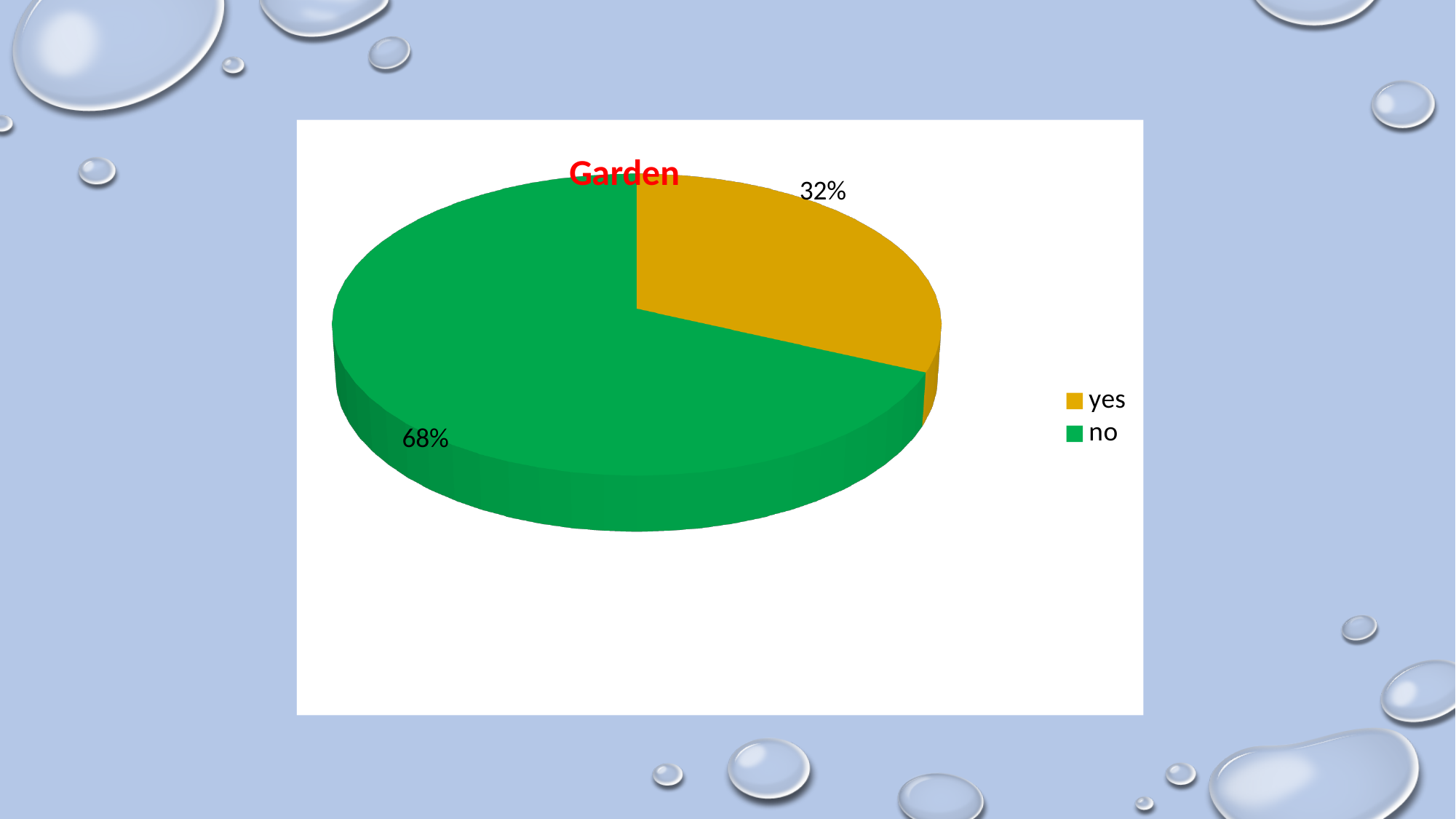
What share of the pie does the "no" slice take? 68% What percentage of the pie is labelled "no"? 68% Which slice is the smallest? yes Which is larger, the "yes" slice or the "no" slice? no What kind of chart is shown on the slide? pie chart How many slices does the pie chart have? 2 What percentage of the pie is labelled "yes"? 32% What colour is the "yes" slice? yellow What is the title of the chart? Garden How many entries does the legend list? 2 Which slice is the largest? no What is the difference in percentage points between the "no" slice and the "yes" slice? 36